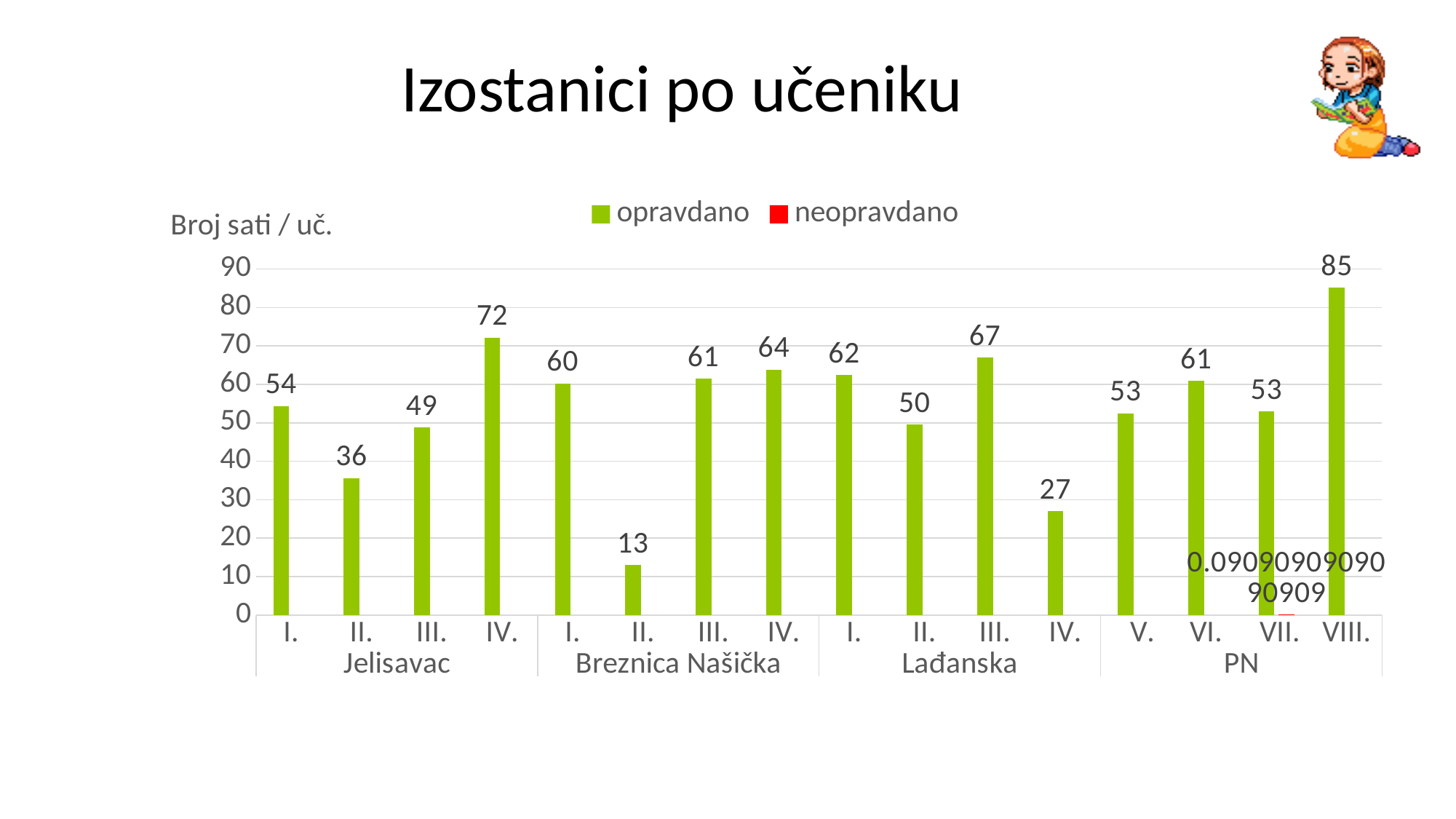
What is the difference between the opravdano values for class IV. in Jelisavac and class I. in Jelisavac? 18 How many series does the legend list? 2 What is the opravdano value for class VIII. in PN? 85 What kind of chart is shown on the slide? bar chart Which class has the highest opravdano value on the chart? VIII. (PN) Is the opravdano value for class II. in Jelisavac greater or less than 40? less How many bars (classes) are plotted on the chart? 16 What is the opravdano value for class II. in Breznica Našička? 13 Which class has the lowest opravdano value on the chart? II. (Breznica Našička) What is the title of the chart? Izostanici po učeniku What is the opravdano value for class IV. in Jelisavac? 72 Which is larger, the opravdano value for class III. in Lađanska or class IV. in Lađanska? III. in Lađanska